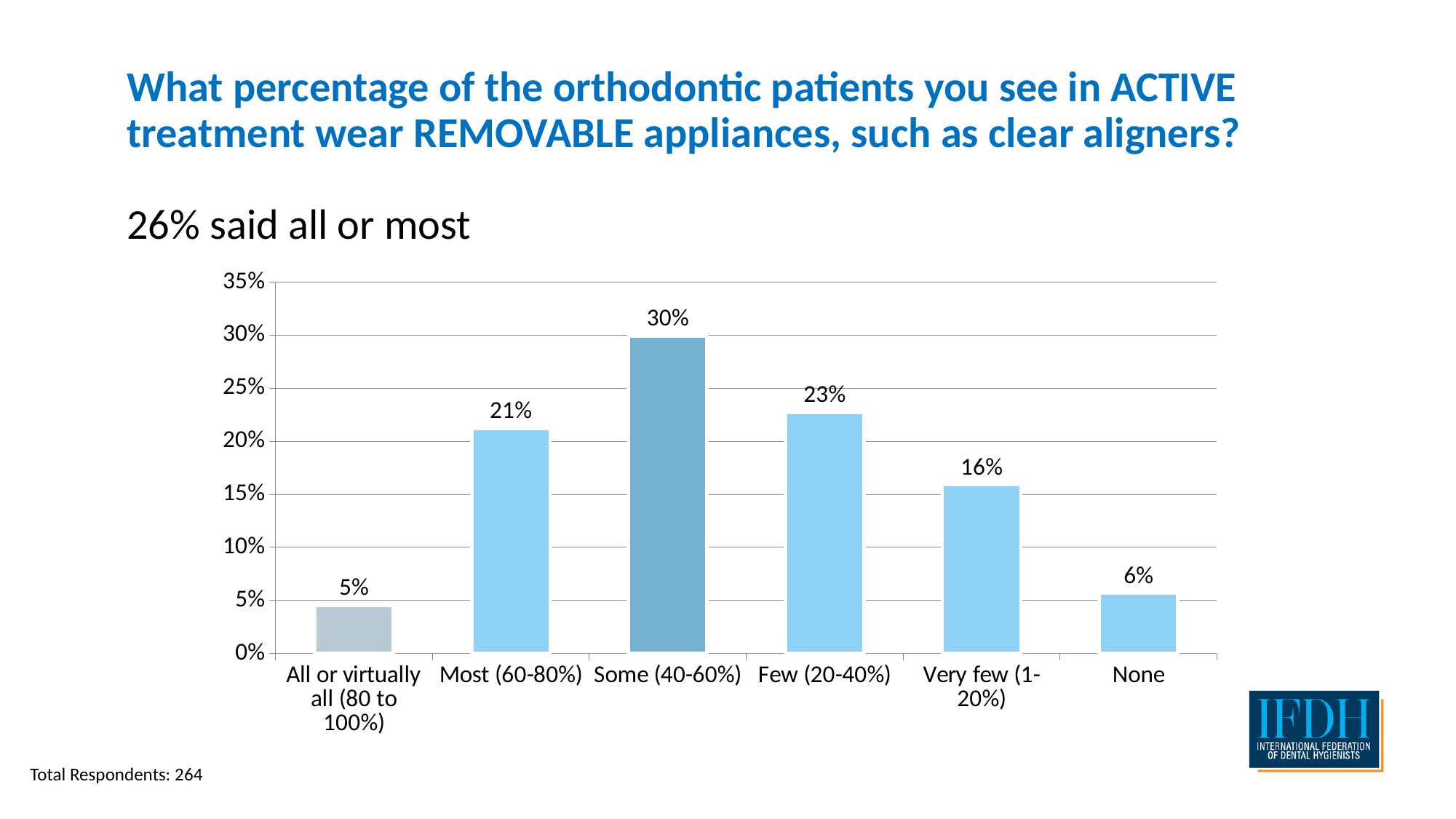
Which is larger, the value for "Most (60-80%)" or the value for "Few (20-40%)"? Few (20-40%) What value is shown for the "None" category? 6% Is the value for "Very few (1-20%)" greater or less than 20%? less What is the total of the values for "All or virtually all (80 to 100%)" and "Most (60-80%)"? 26% What is the difference between the values for "Some (40-60%)" and "Few (20-40%)"? 7% How many total respondents are noted on the slide? 264 What percentage of respondents chose "Some (40-60%)"? 30% Which category has the lowest value? All or virtually all (80 to 100%) What kind of chart is shown on the slide? bar chart What percentage is shown for "Very few (1-20%)"? 16% Which category has the highest value? Some (40-60%) How many categories are shown on the x axis? 6